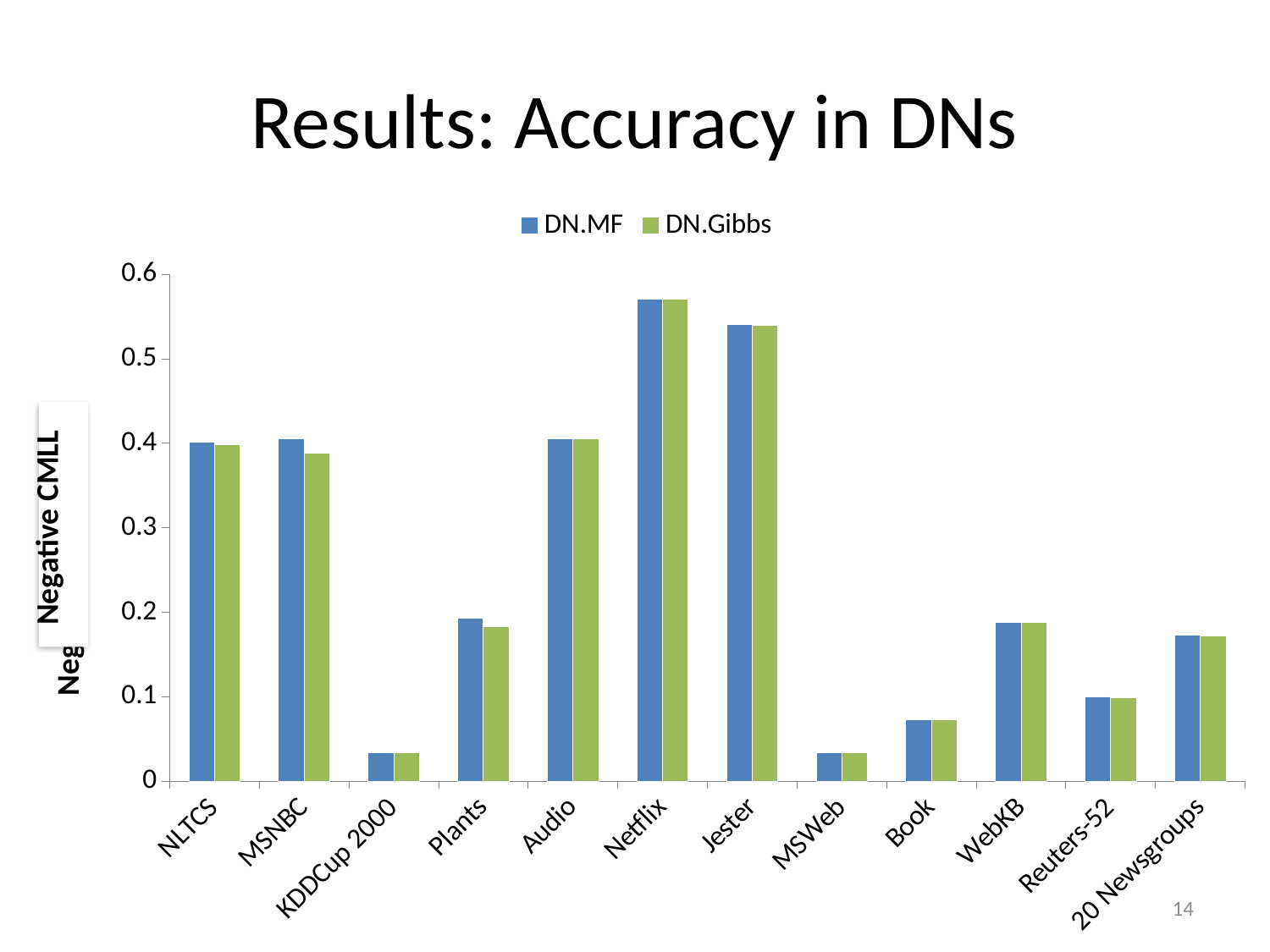
For DN.MF, which is larger: Netflix or Jester? Netflix For DN.MF, which is larger: Book or Reuters-52? Reuters-52 Which dataset has the highest Negative CMLL for DN.Gibbs? Netflix What is the label on the y axis? Negative CMLL Is the DN.Gibbs value for 20 Newsgroups greater or less than 0.2? less Is the DN.MF value for Book greater or less than 0.1? less Which dataset has the highest Negative CMLL for DN.MF? Netflix How many series does the legend list? 2 Is the DN.MF value for Netflix greater or less than 0.5? greater What kind of chart is shown on the slide? bar chart How many datasets (categories) are shown on the x axis? 12